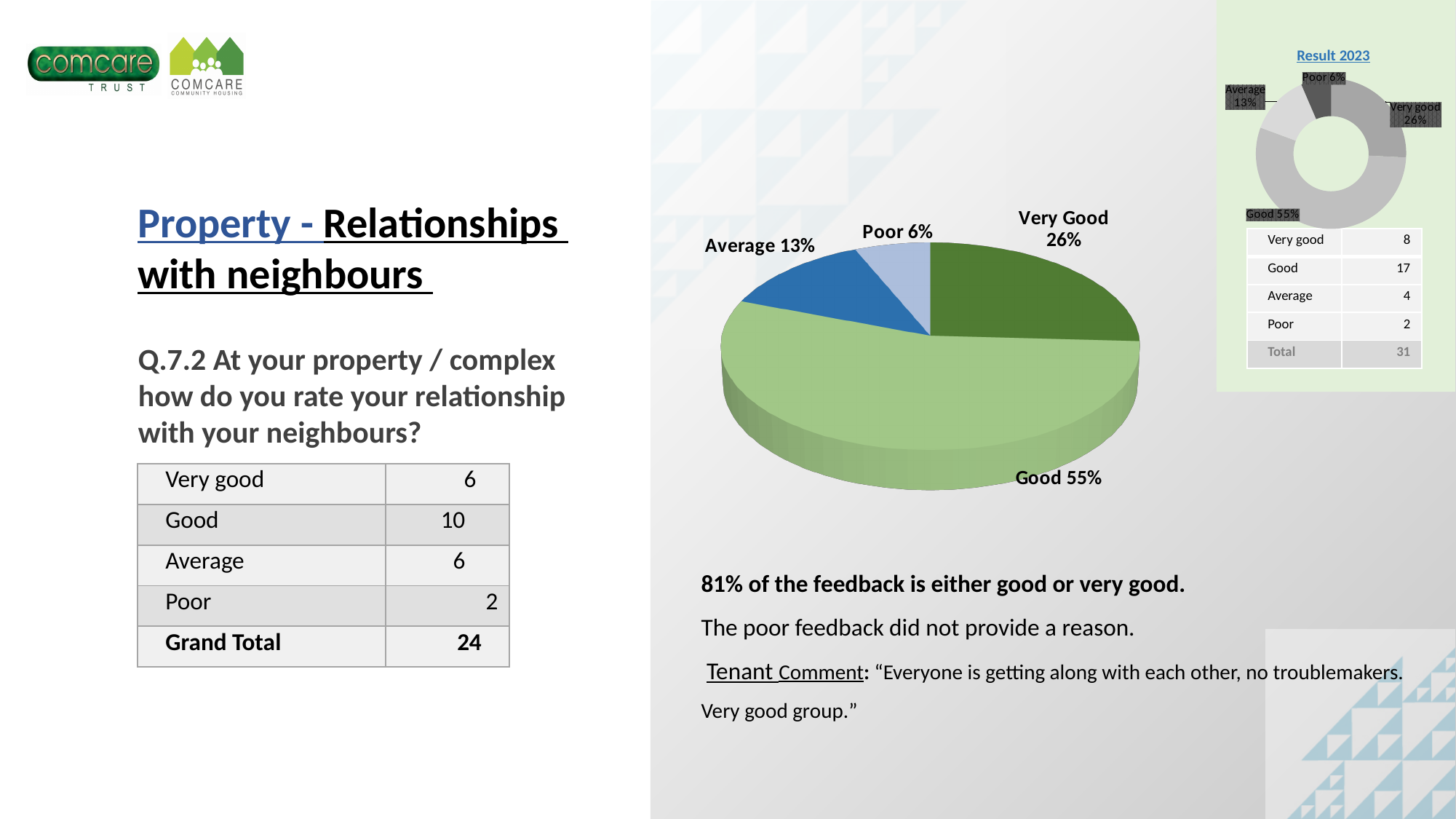
In the large pie chart, what share is labelled for Good? 55% In the large pie chart, which category has the smallest slice? Poor What kind of chart is the large chart in the centre of the slide? Pie chart In the large pie chart, which category has the largest slice? Good In the large pie chart, how many percentage points larger is the Good slice than the Very Good slice? 29 percentage points In the large pie chart, what colour is the Good slice? Light green How many slices does the large pie chart have? 4 In the large pie chart, which slice is larger, Average or Poor? Average In the Result 2023 chart, what share is labelled for Good? 55% In the large pie chart, what share is labelled for Very Good? 26% In the large pie chart, what share is labelled for Average? 13% What is the title of the small chart in the top right of the slide? Result 2023